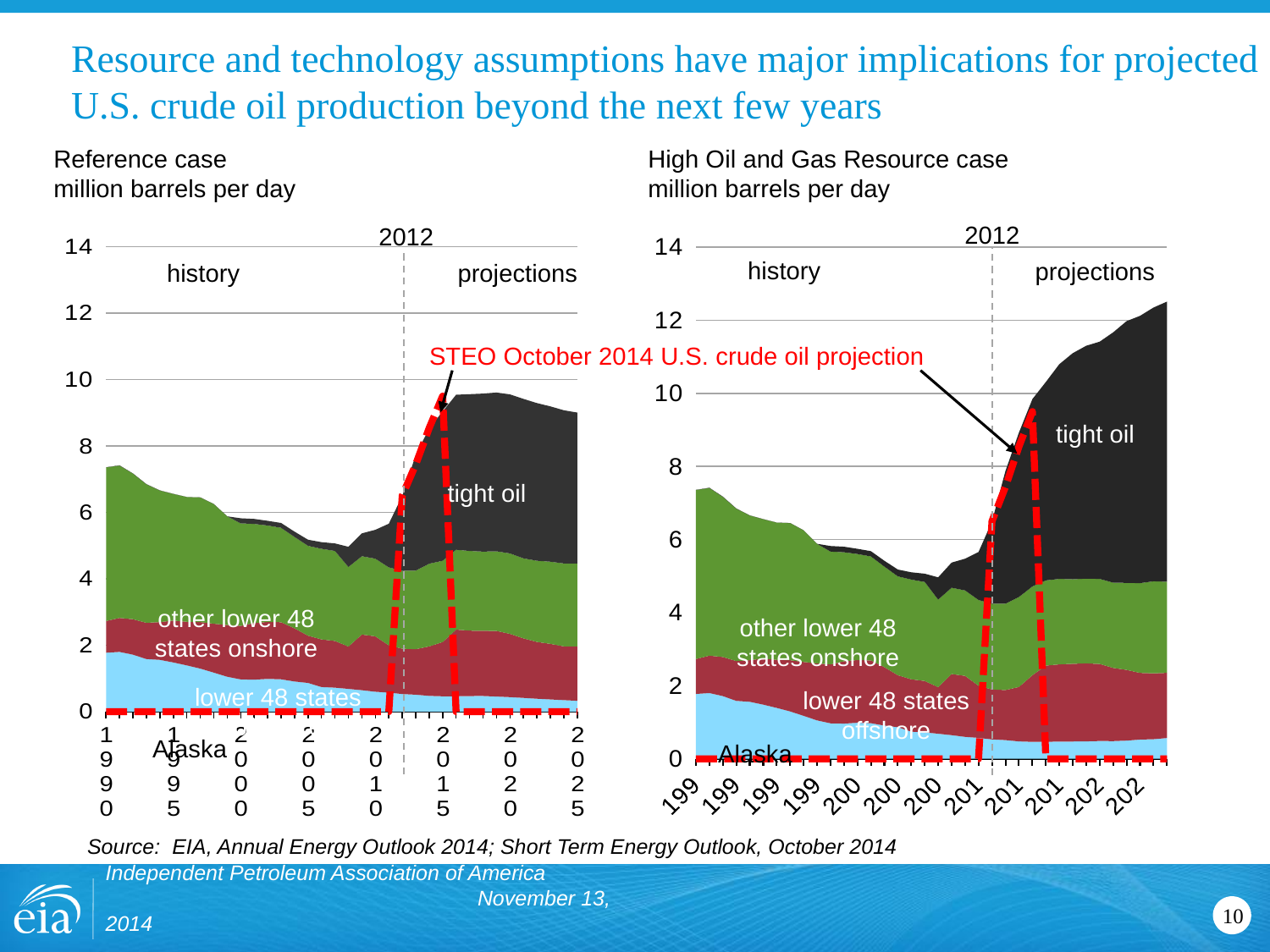
In the High Oil and Gas Resource case chart, which category is the largest contributor to total production in 2025? tight oil In the High Oil and Gas Resource case chart, does total crude oil production rise or fall between 2012 and 2025? rise What kind of chart is the Reference case chart on the left? stacked area chart In the Reference case chart, is the total crude oil production in 2025 greater or less than 8 million barrels per day? greater In the High Oil and Gas Resource case chart, is the total crude oil production in 2025 greater or less than 10 million barrels per day? greater What unit is used on the y axis of both charts? million barrels per day In the Reference case chart, does total crude oil production rise or fall between 1990 and 2005? fall Which year does the dashed vertical line separating history from projections mark in both charts? 2012 In the High Oil and Gas Resource case chart, how many production categories are labeled within the plot area? 4 In the Reference case chart, is the total crude oil production in 2025 greater or less than 10 million barrels per day? less Which chart shows the higher total crude oil production in 2025, the Reference case or the High Oil and Gas Resource case? High Oil and Gas Resource case